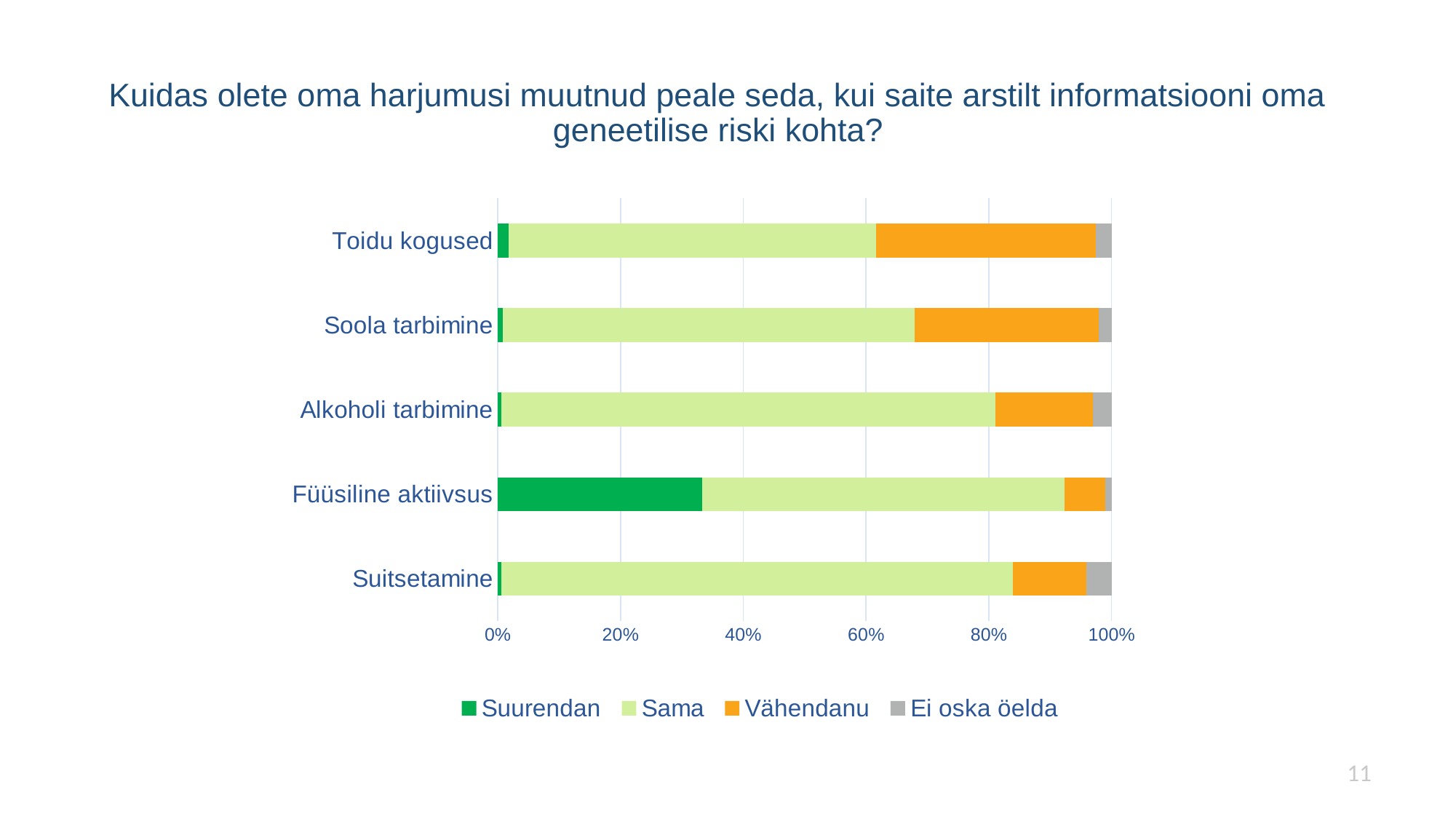
Which has a larger 'Vähendanu' segment, Toidu kogused or Alkoholi tarbimine? Toidu kogused Which category has the largest 'Vähendanu' segment? Toidu kogused Which colour represents the 'Vähendanu' series in the legend? Orange Is the 'Sama' share for Soola tarbimine greater or less than 60%? greater Which category has the smallest 'Vähendanu' segment? Füüsiline aktiivsus How many series does the legend list? 4 Which category has the largest 'Suurendan' segment? Füüsiline aktiivsus What kind of chart is shown on the slide? Stacked bar chart How many categories (habits) are shown on the chart? 5 Which has a larger 'Suurendan' segment, Füüsiline aktiivsus or Suitsetamine? Füüsiline aktiivsus Is the 'Suurendan' share for Füüsiline aktiivsus greater or less than 40%? less Is the 'Suurendan' share for Füüsiline aktiivsus greater or less than 20%? greater